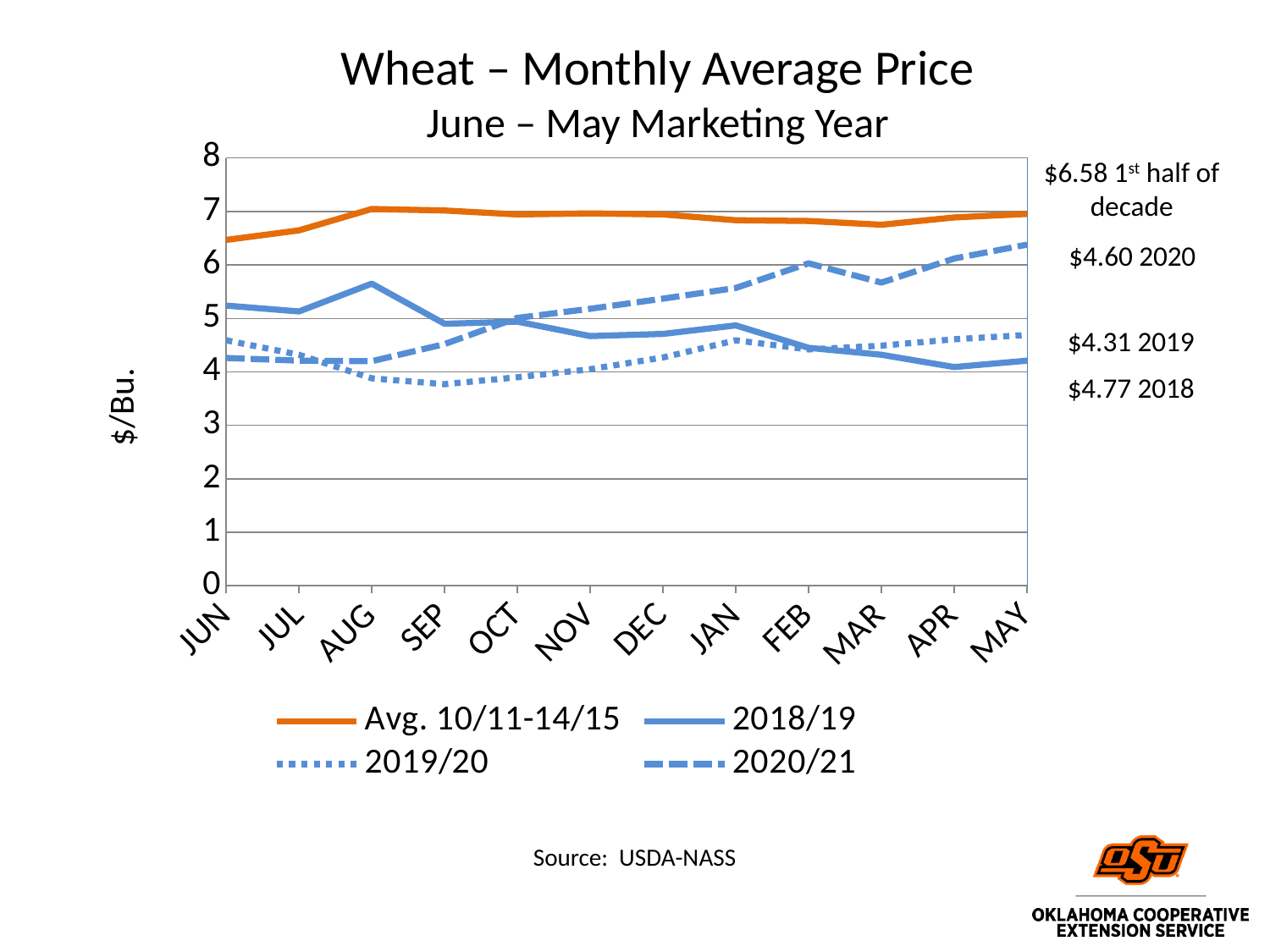
Does the 2020/21 series generally rise or fall from JUN to MAY? rise In DEC, which series is higher: 2018/19 or 2020/21? 2020/21 What is the label on the y axis? $/Bu. How many series does the legend list? 4 Is the value for 2020/21 in MAY greater or less than 6? greater How many months are shown along the x axis? 12 Which series has the highest prices across the whole marketing year? Avg. 10/11-14/15 Is the value for 2019/20 in SEP greater or less than 4? less Is the value for 2018/19 in AUG greater or less than 5? greater In which month does the 2018/19 series reach its highest value? AUG In which month does the 2020/21 series reach its highest value? MAY What kind of chart is shown on the slide? line chart